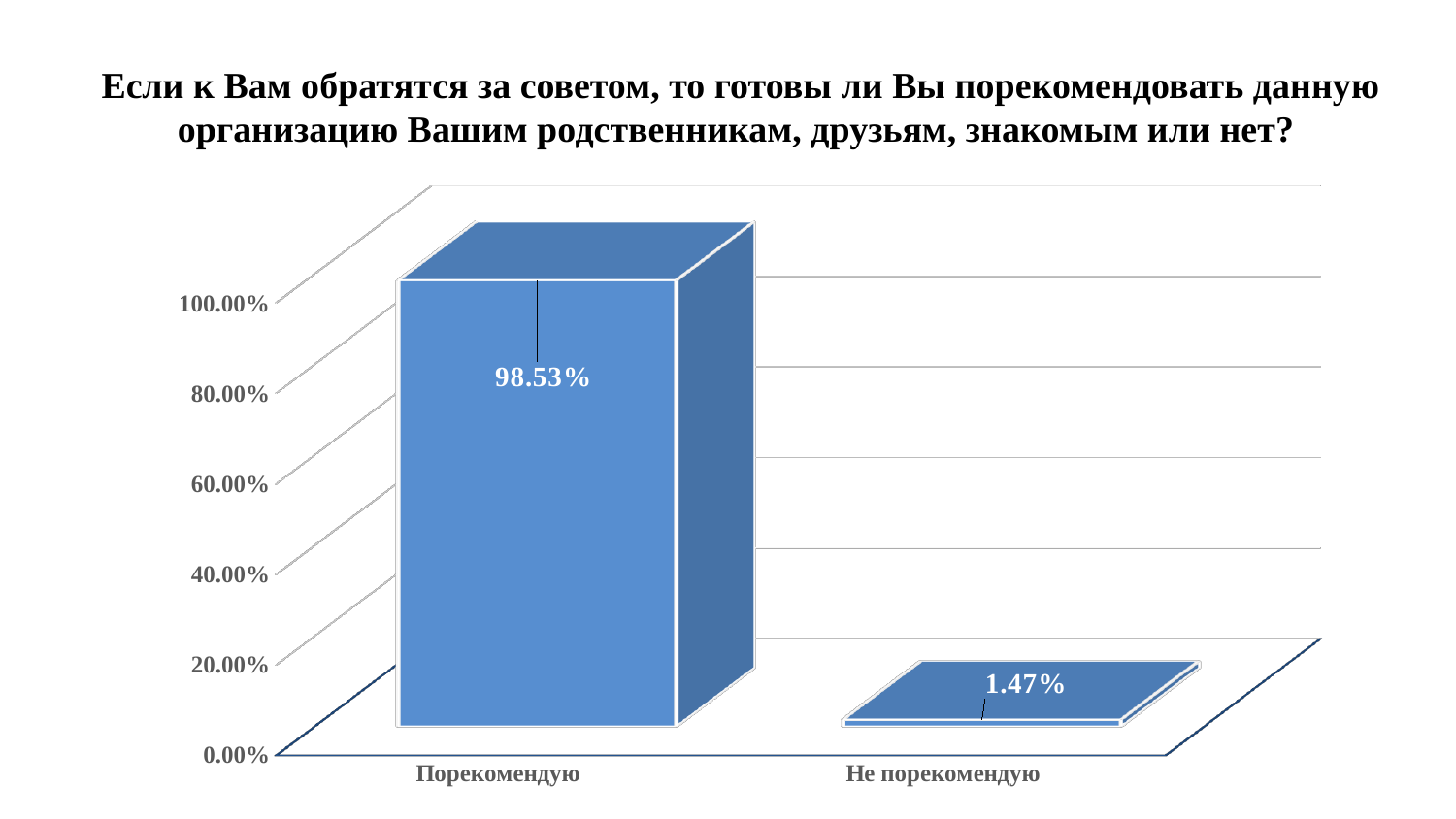
Which category has the lowest value? Не порекомендую Which is larger, the value for Порекомендую or the value for Не порекомендую? Порекомендую What is the value for Не порекомендую? 1.47% Is the value for Порекомендую greater or less than 80.00%? greater Which category has the highest value? Порекомендую Is the value for Не порекомендую greater or less than 20.00%? less How many categories are shown on the x axis? 2 What kind of chart is shown on the slide? bar chart What is the highest value shown on the vertical axis? 100.00% What is the total of the two values shown in the chart? 100.00% What is the difference between the values for Порекомендую and Не порекомендую? 97.06% What is the value for Порекомендую? 98.53%